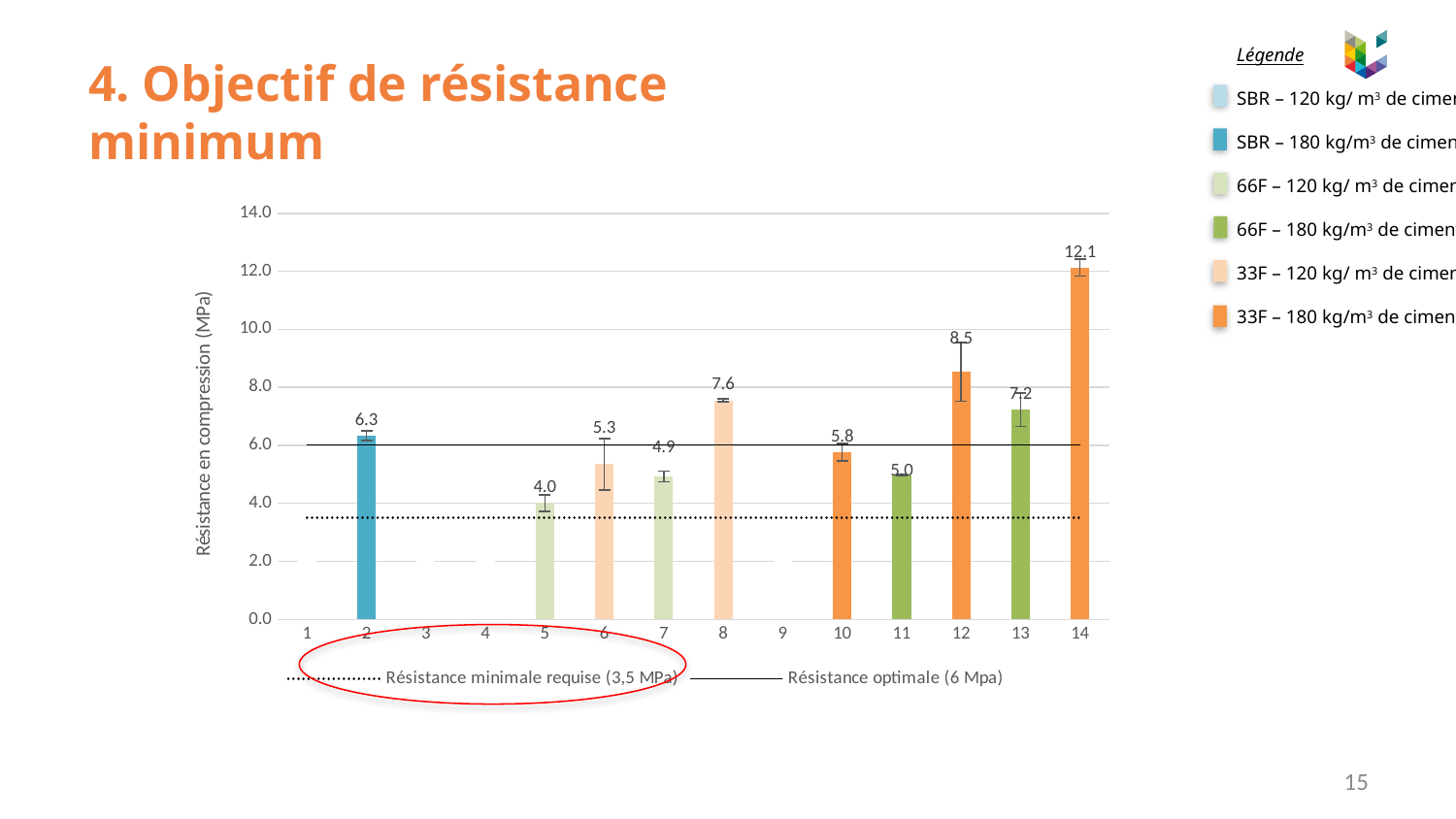
What is the value of the bar at category 2? 6.3 Is the value for category 11 greater or less than 6.0? less How many bars are plotted in the chart? 10 What is the value of the bar at category 8? 7.6 What does the dotted horizontal line represent, according to the chart legend? Résistance minimale requise (3,5 MPa) What is the difference between the values at category 14 and category 12? 3.6 What is the label of the y axis? Résistance en compression (MPa) Which category has the lowest bar? 5 What is the value of the bar at category 14? 12.1 What kind of chart is shown on the slide? Bar chart Which category has the highest bar? 14 Which is larger, the value at category 8 or the value at category 13? Category 8